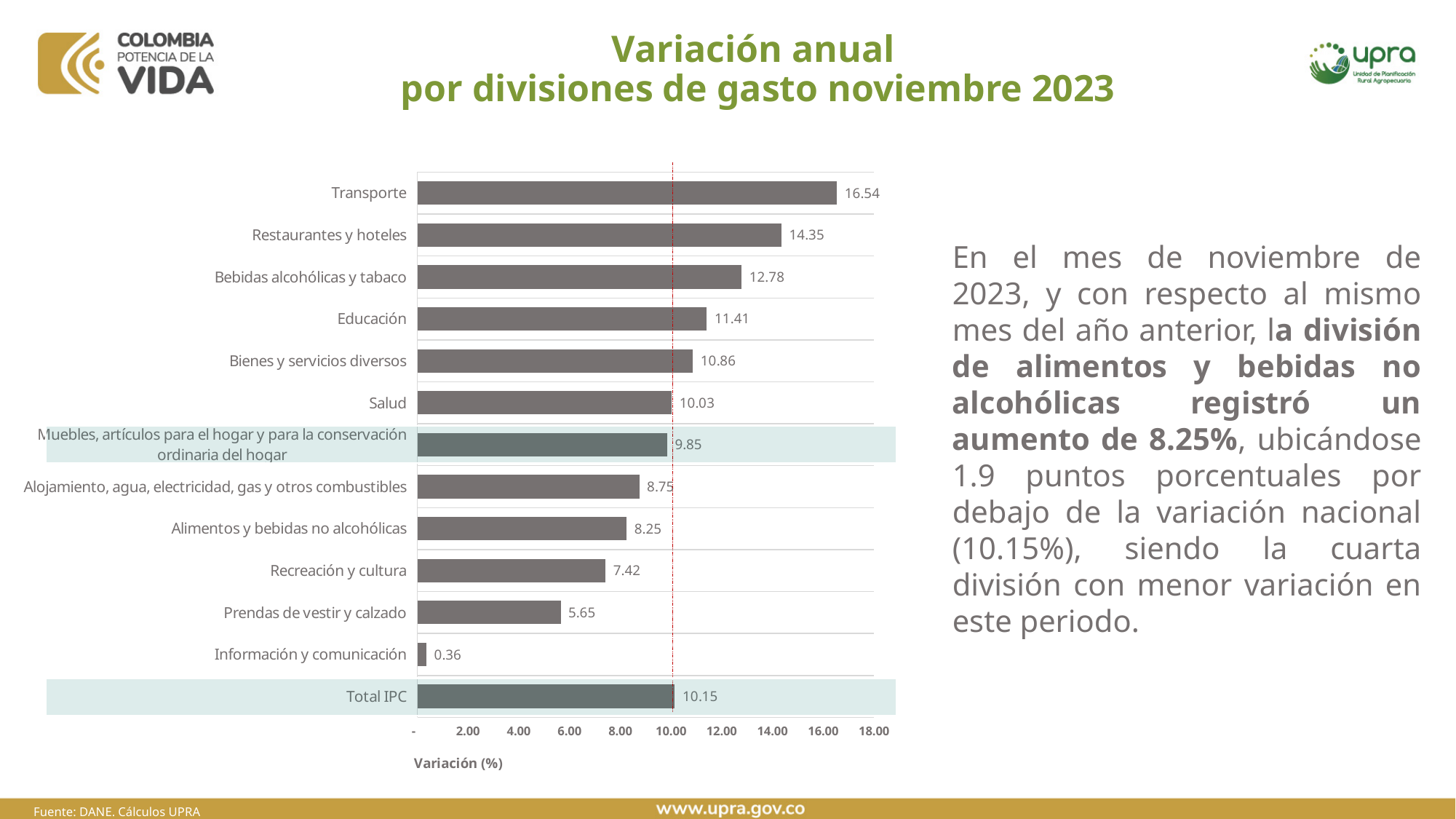
What is the value for Transporte? 16.54 Is the value for Recreación y cultura greater or less than 8.00? less Which is larger, the value for Educación or the value for Salud? Educación Which category has the lowest value? Información y comunicación What kind of chart is shown on the slide? bar chart How many bars are shown in the chart? 13 Which category has the highest value? Transporte What is the value for Alimentos y bebidas no alcohólicas? 8.25 What is the difference between the Total IPC value and the value for Alimentos y bebidas no alcohólicas? 1.9 What is the value for Información y comunicación? 0.36 What is the difference between the values for Transporte and Restaurantes y hoteles? 2.19 What is the value for Total IPC? 10.15